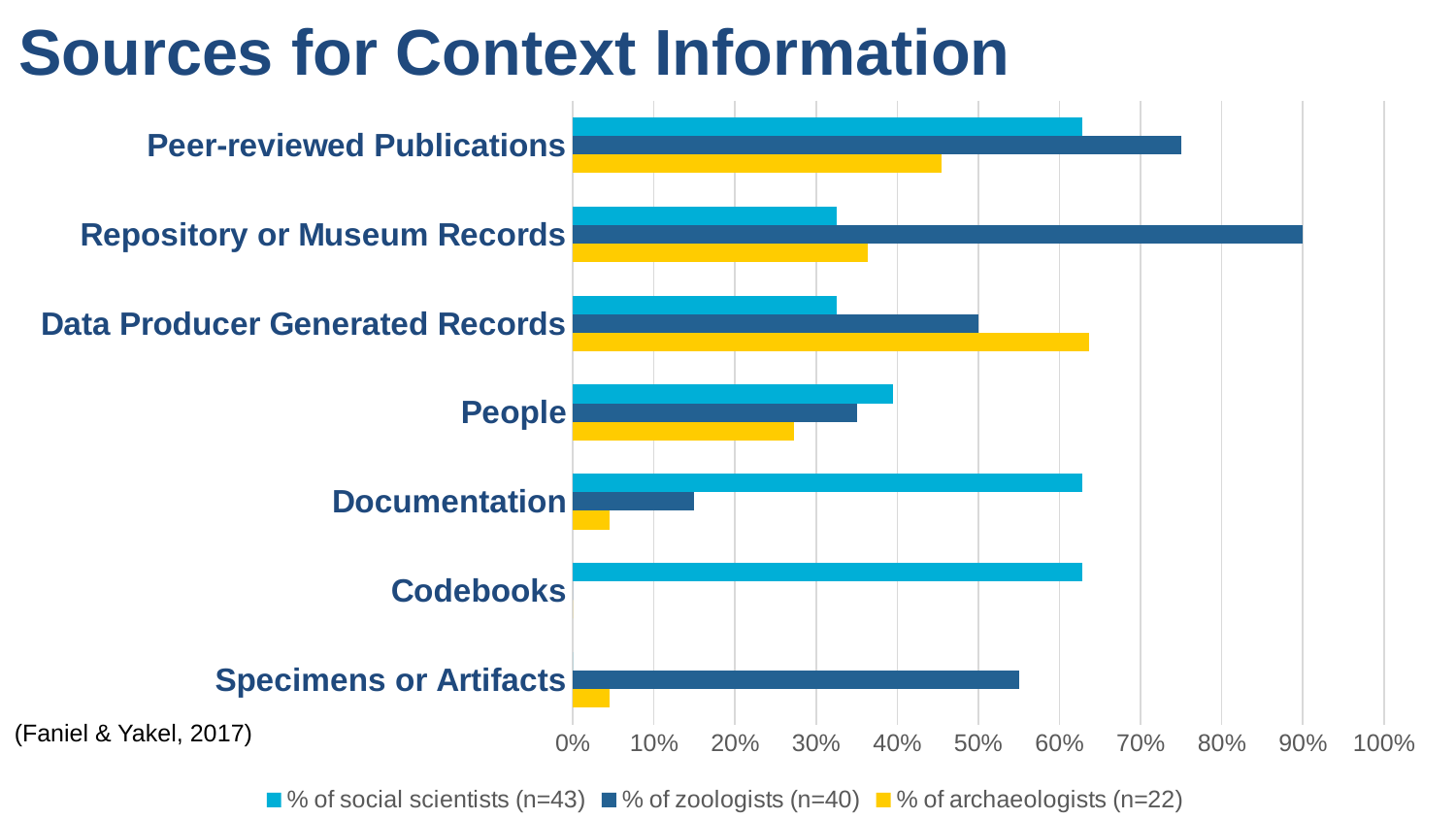
How many series does the legend list? 3 For which category is the value for archaeologists highest? Data Producer Generated Records What is the title of the chart? Sources for Context Information What kind of chart is shown on the slide? bar chart What is the value for zoologists for Repository or Museum Records? 90% For which category is the value for zoologists highest? Repository or Museum Records Which series does the yellow bar represent? % of archaeologists (n=22) For Documentation, which is larger: the value for social scientists or the value for zoologists? social scientists What is the value for zoologists for Data Producer Generated Records? 50% Is the value for archaeologists for People greater or less than 30%? less How many source categories are listed on the chart? 7 Is the value for social scientists for Peer-reviewed Publications greater or less than 60%? greater